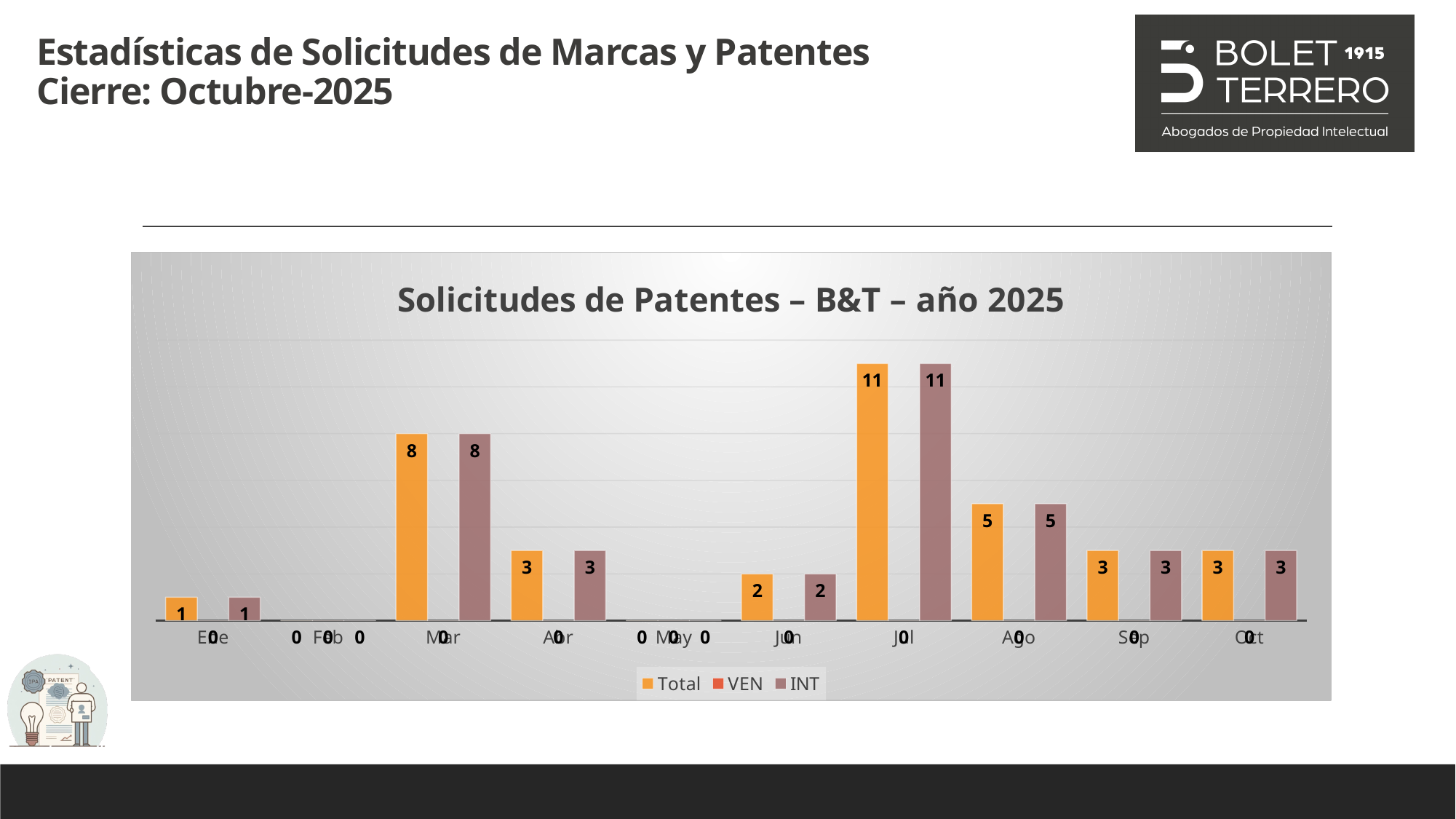
What is the difference between the Total values for Jul and Mar? 3 Which month has the highest Total value? Jul What is the difference between the Total values for Sep and Ene? 2 What kind of chart is shown on the slide? Bar chart What is the title of the chart? Solicitudes de Patentes – B&T – año 2025 How many months are shown on the x axis of the chart? 10 Which is larger, the Total value for Ago or the Total value for Abr? Ago What is the INT value for Mar? 8 What is the Total value for Ago? 5 What is the Total value for Jul in the chart? 11 What is the INT value for Jun? 2 How many series does the legend list? 3